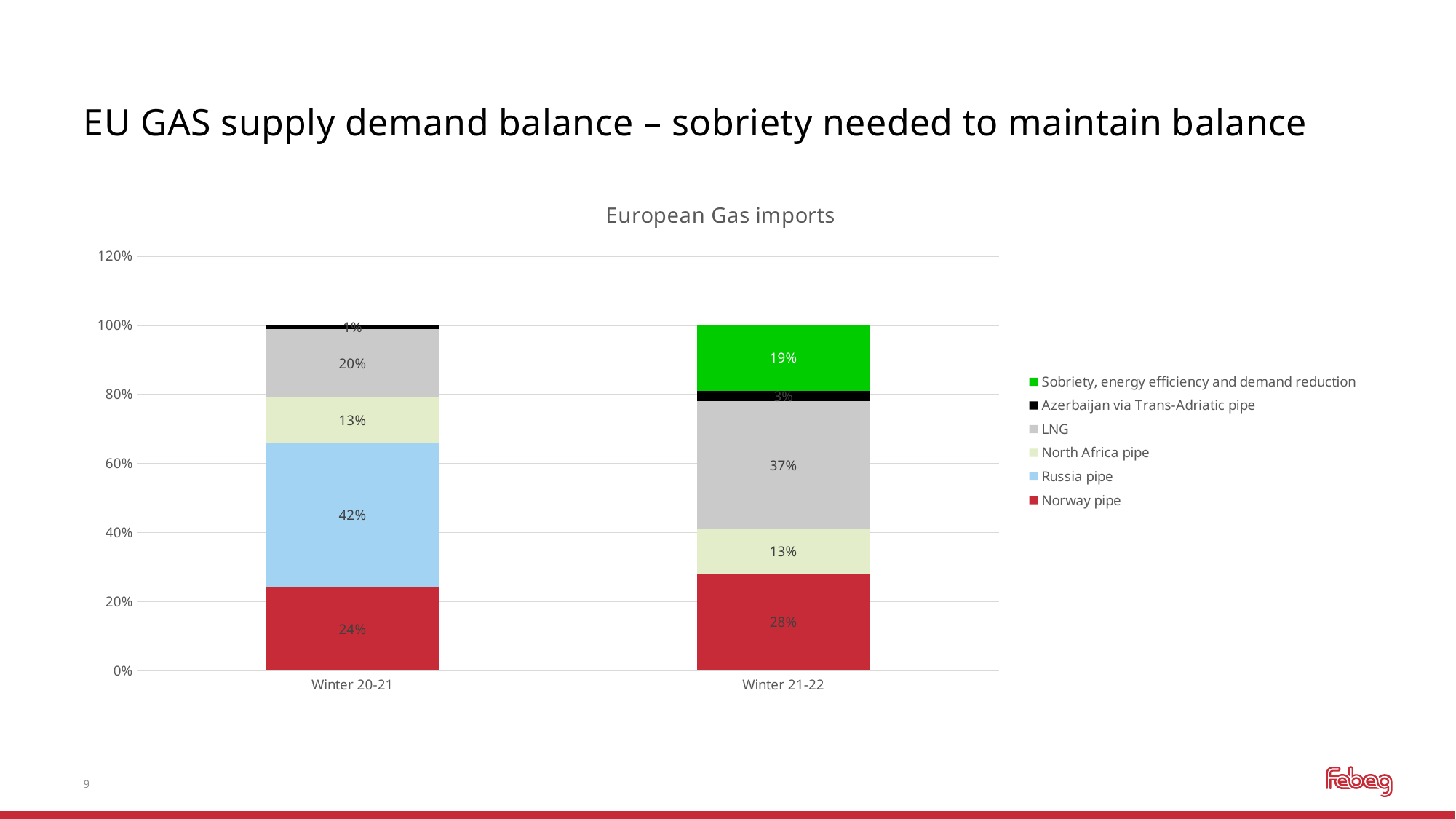
What is the value for LNG in Winter 21-22? 37% How many series does the legend list? 6 What is the value for Norway pipe in Winter 21-22? 28% What kind of chart is shown on the slide? Stacked bar chart What is the difference between the LNG share in Winter 21-22 and in Winter 20-21? 17% What is the value for Russia pipe in Winter 20-21? 42% What is the title of the chart? European Gas imports Which is larger: Norway pipe in Winter 20-21 or Norway pipe in Winter 21-22? Winter 21-22 Which series has the largest share in Winter 20-21? Russia pipe What is the total of the stacked bar for Winter 21-22? 100% What is the value for Sobriety, energy efficiency and demand reduction in Winter 21-22? 19% How many categories are shown on the x axis? 2